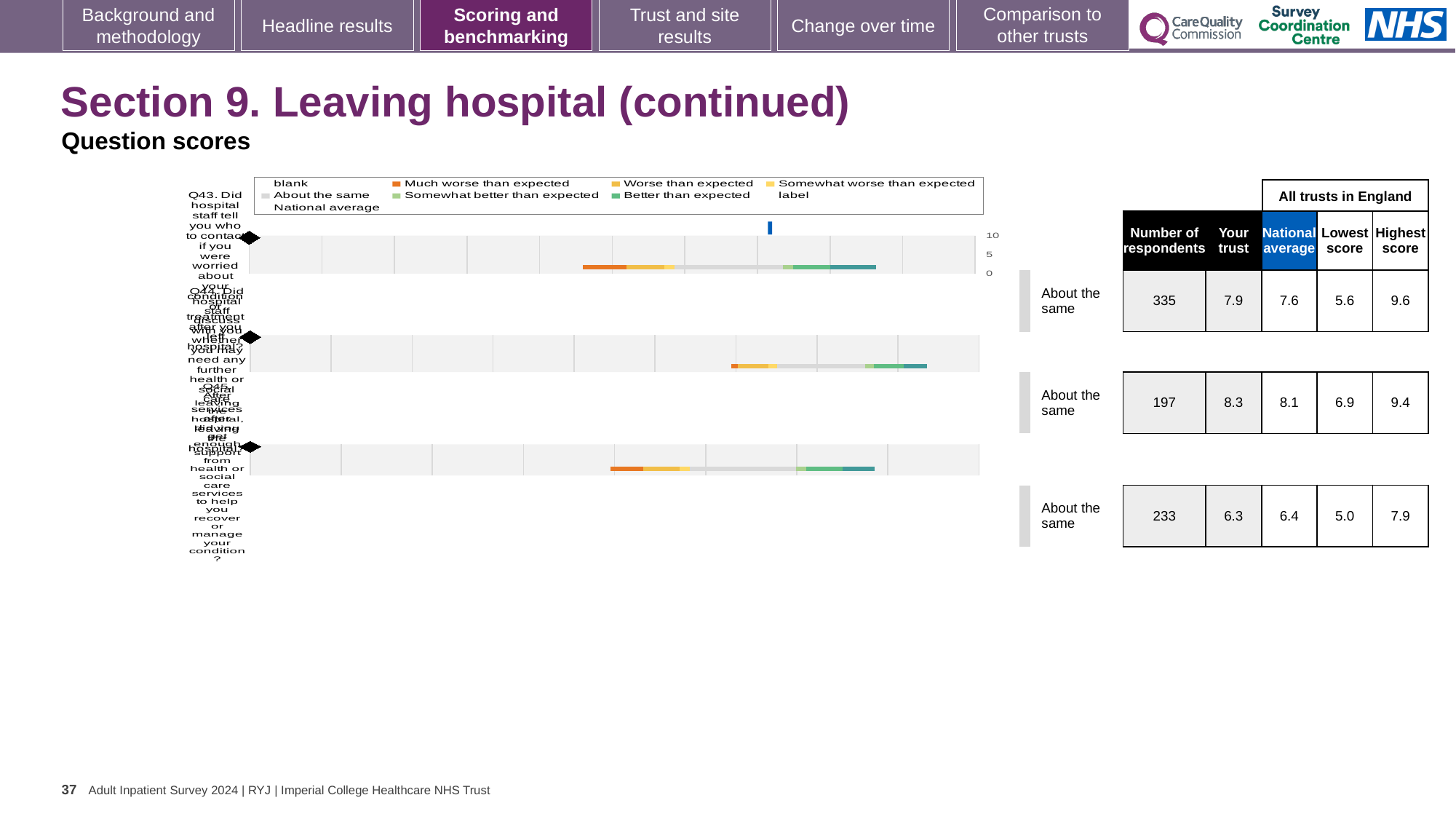
How many question charts (rows) are shown on the slide? 3 For the first question chart (Q43), what is the number of respondents shown in the table? 335 For the third question chart (Q45), what is the highest score among all trusts in England? 7.9 For the first question chart (Q43), what is the 'Your trust' score? 7.9 For the third question chart (Q45), which is larger: the 'Your trust' score or the national average? National average For the second question chart (Q44), what is the lowest score among all trusts in England? 6.9 What kind of chart is used to show the question scores on this slide? bar chart For the first question chart (Q43), what is the national average score? 7.6 For the first question chart (Q43), what is the difference between the 'Your trust' score and the national average? 0.3 Which of the three question charts has the highest 'Your trust' score? the second chart (Q44), 8.3 What benchmark category is shown for the third question chart (Q45)? About the same